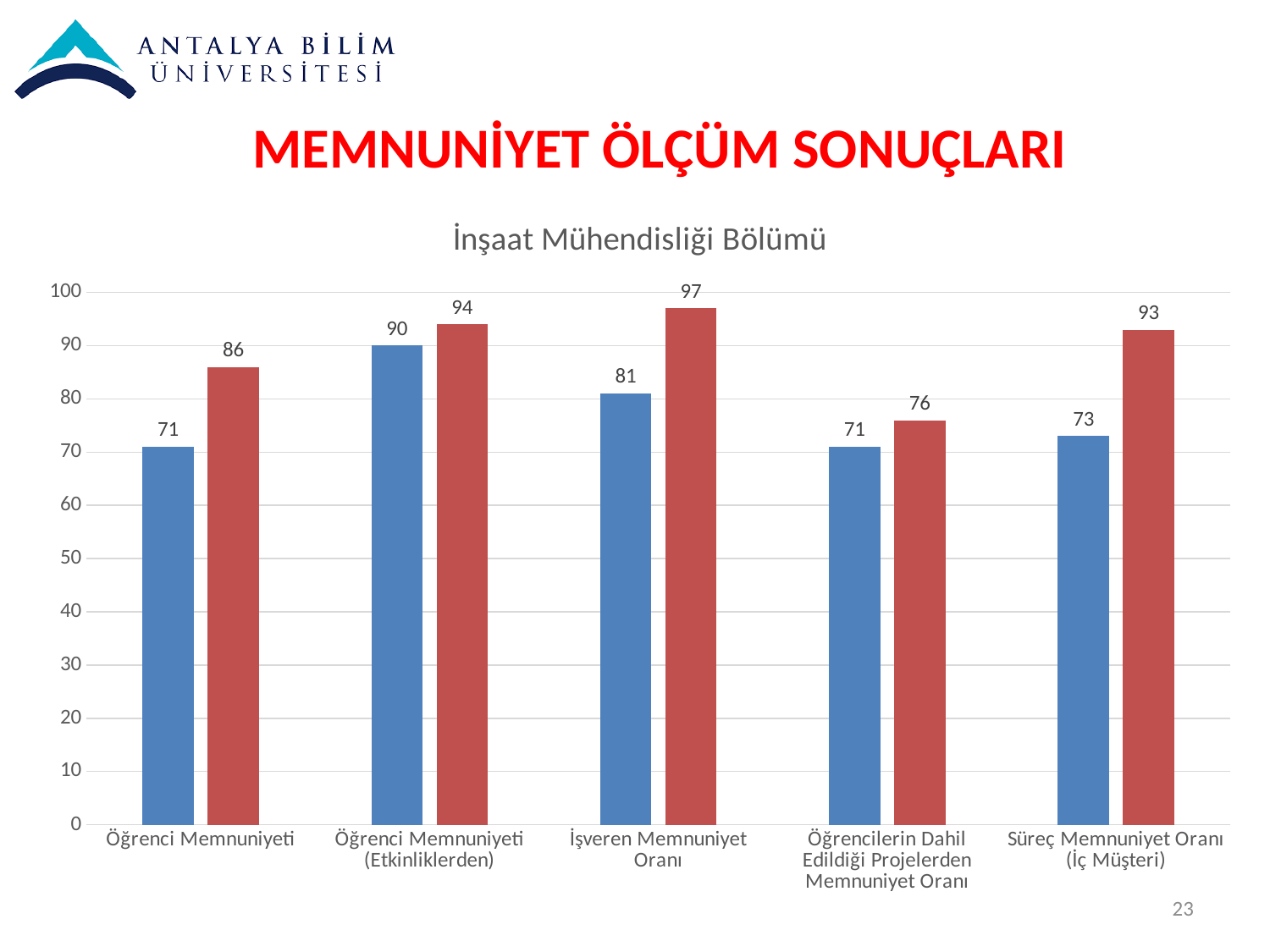
What type of chart is shown on the slide? Bar chart What is the difference between the red and blue bars for Süreç Memnuniyet Oranı (İç Müşteri)? 20 Which is larger, the blue bar for İşveren Memnuniyet Oranı or the blue bar for Süreç Memnuniyet Oranı (İç Müşteri)? İşveren Memnuniyet Oranı Which category has the lowest red bar? Öğrencilerin Dahil Edildiği Projelerden Memnuniyet Oranı What is the value of the blue bar for Öğrenci Memnuniyeti? 71 What is the value of the blue bar for Öğrenci Memnuniyeti (Etkinliklerden)? 90 How many categories are shown on the x axis? 5 What is the value of the red bar for İşveren Memnuniyet Oranı? 97 What is the difference between the red and blue bars for Öğrenci Memnuniyeti (Etkinliklerden)? 4 What is the title of the chart? İnşaat Mühendisliği Bölümü Which category has the highest red bar? İşveren Memnuniyet Oranı What is the value of the red bar for Süreç Memnuniyet Oranı (İç Müşteri)? 93